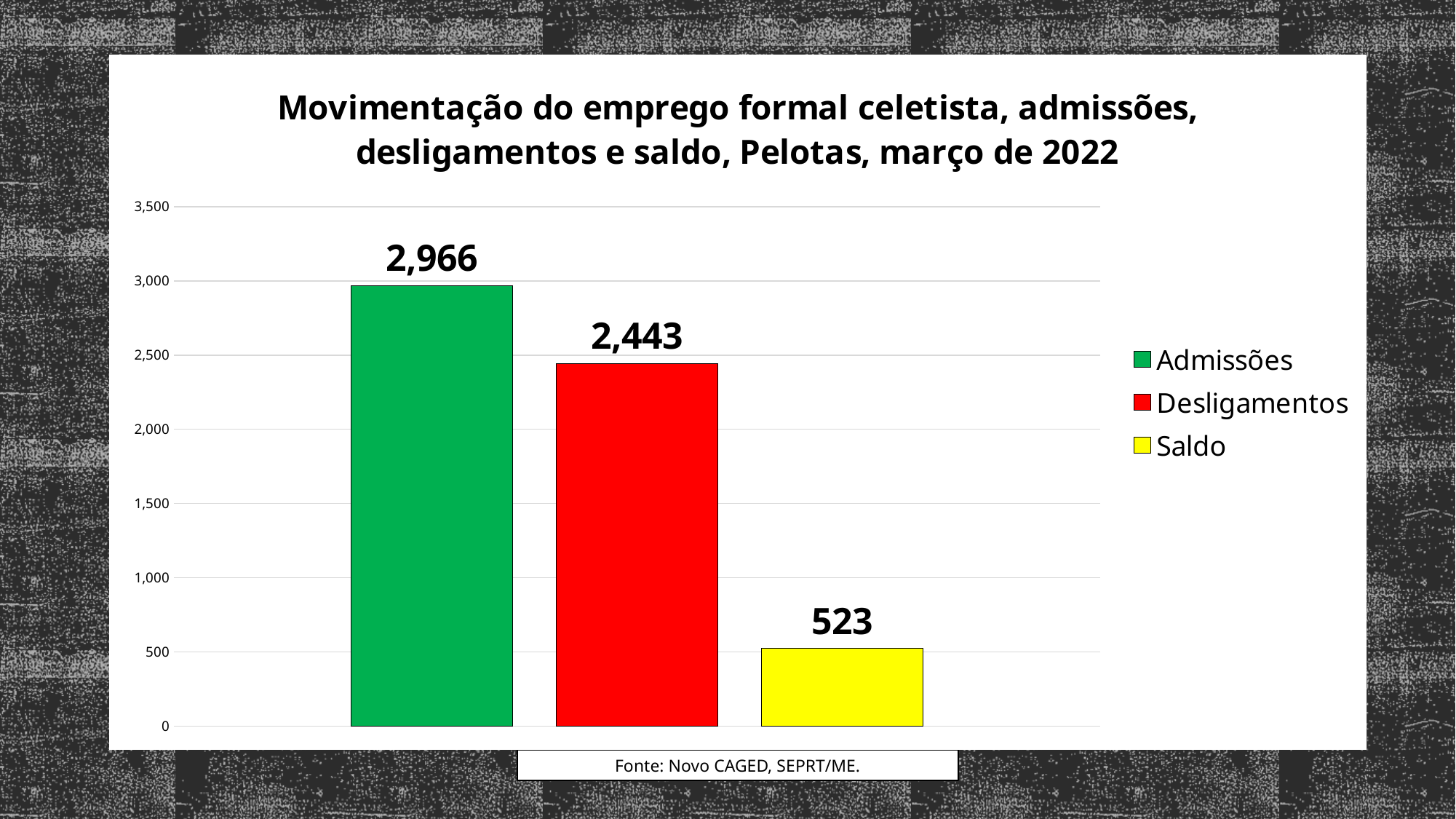
What is the value for Desligamentos? 2,443 How many series does the legend list? 3 Which series has the highest value? Admissões How many bars are plotted in the chart? 3 What is the value for Saldo? 523 Which is larger, Desligamentos or Saldo? Desligamentos What is the value for Admissões? 2,966 Is the value for Desligamentos greater or less than 2,500? less What kind of chart is shown on the slide? bar chart What colour is the bar for Saldo? yellow Which series has the lowest value? Saldo What is the difference between Admissões and Desligamentos? 523